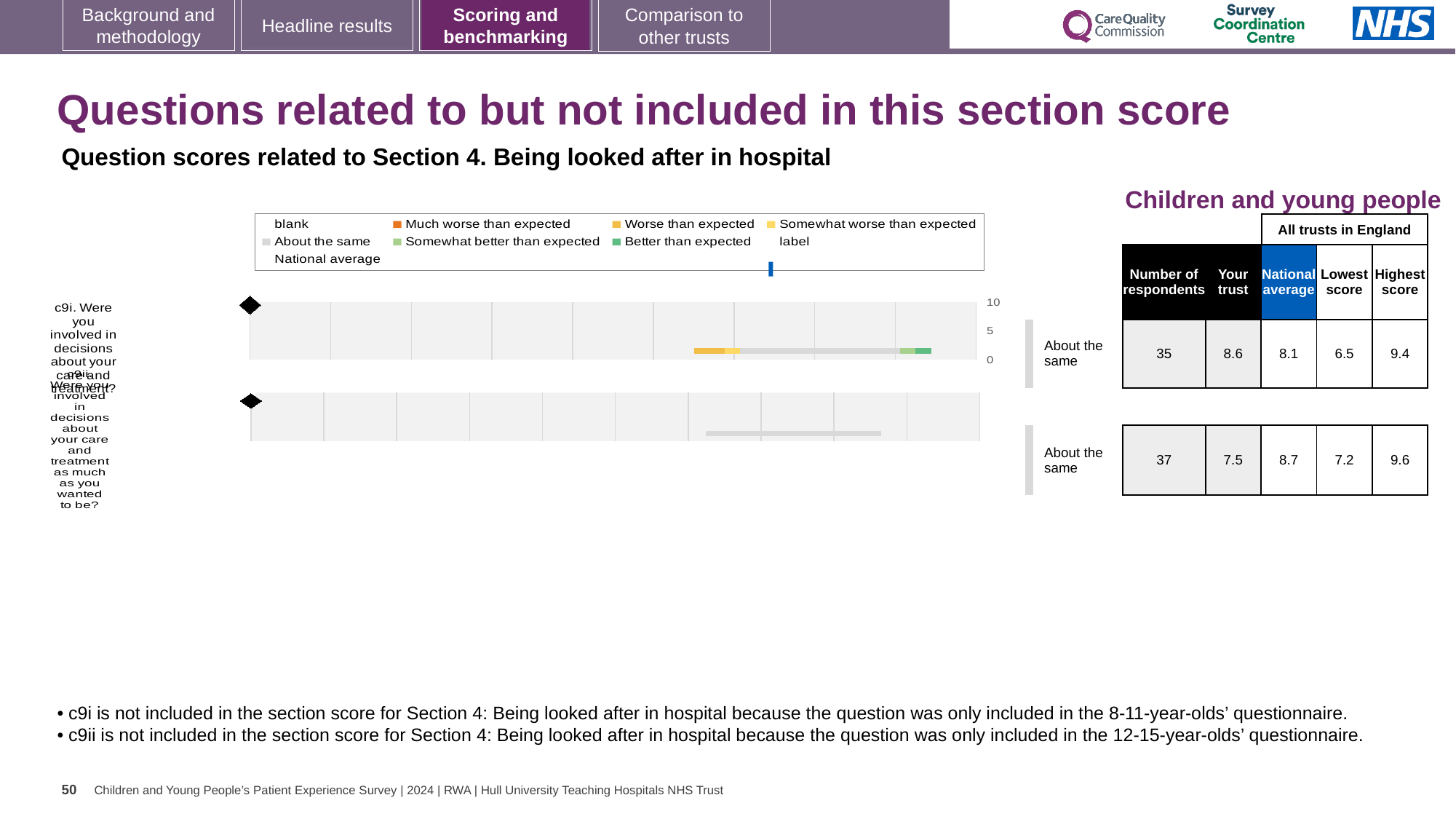
How many questions (c9i and c9ii) are plotted on the slide? 2 For c9i, which is larger: the 'Your trust' score or the national average? Your trust How many entries does the legend above the charts list? 9 What benchmark label is shown next to the c9ii chart? About the same What is the difference between the highest and lowest scores among all trusts in England for c9i? 2.9 What kind of chart is used to show the question scores for c9i and c9ii? bar chart For c9ii, which is larger: the 'Your trust' score or the national average? National average What is the difference between the 'Your trust' score and the national average for c9i? 0.5 In the table beside the charts, what is the 'Your trust' score for c9i? 8.6 In the table beside the charts, what is the highest score among all trusts in England for c9ii? 9.6 In the table beside the charts, what is the number of respondents for c9i? 35 In the table beside the charts, what is the national average for c9ii? 8.7